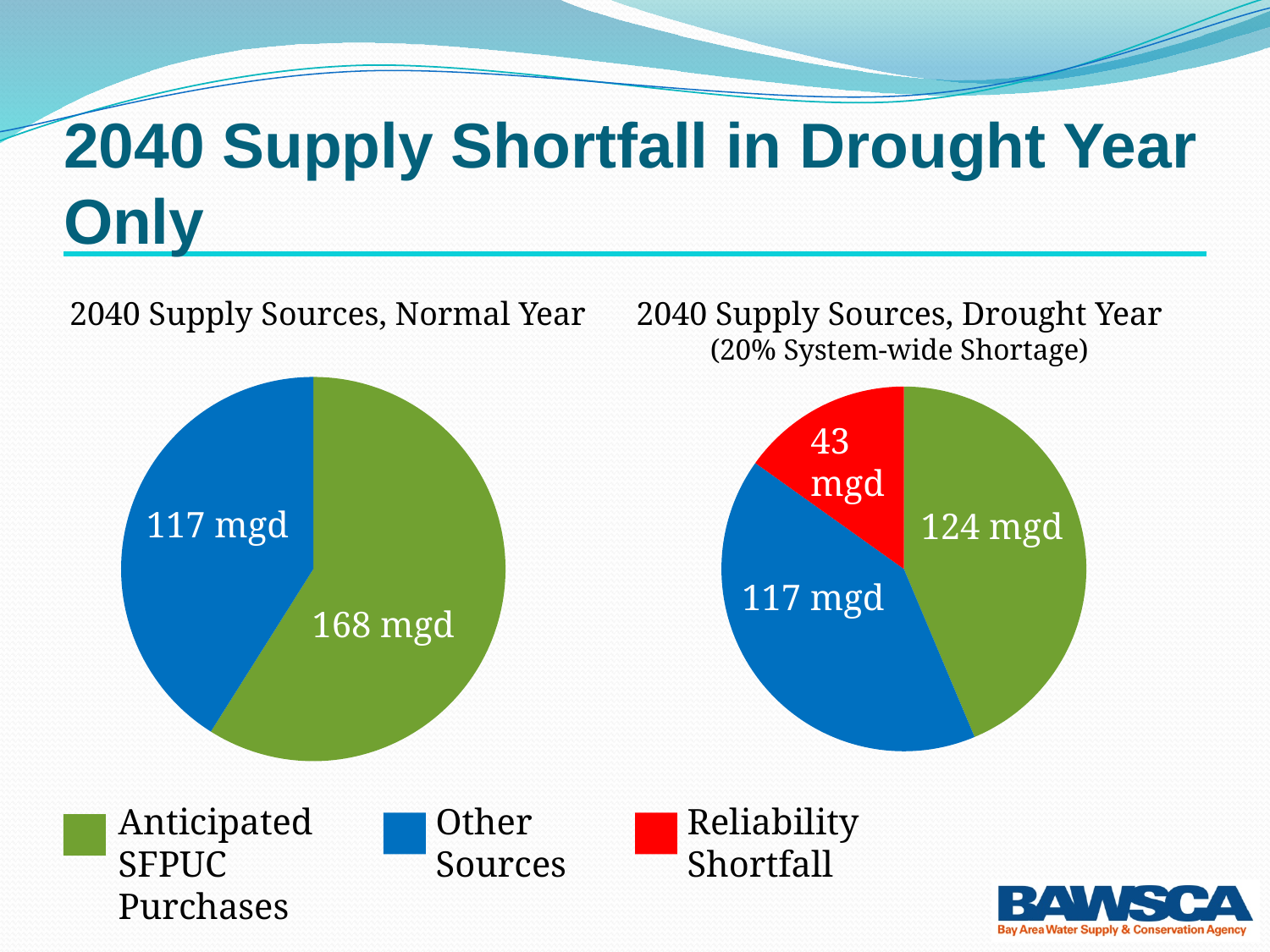
In the 2040 Supply Sources, Drought Year chart, which category has the smallest slice? Reliability Shortfall In the 2040 Supply Sources, Normal Year chart, what is the value for Other Sources? 117 mgd What kind of chart is used for 2040 Supply Sources, Normal Year? Pie chart Which colour represents Reliability Shortfall in the legend? Red How many slices does the 2040 Supply Sources, Drought Year chart have? 3 What is the difference between Anticipated SFPUC Purchases in the Normal Year chart and in the Drought Year chart? 44 mgd In the 2040 Supply Sources, Drought Year chart, what is the value for Reliability Shortfall? 43 mgd In the 2040 Supply Sources, Drought Year chart, which is larger, Anticipated SFPUC Purchases or Reliability Shortfall? Anticipated SFPUC Purchases In the 2040 Supply Sources, Normal Year chart, what is the value for Anticipated SFPUC Purchases? 168 mgd In the 2040 Supply Sources, Normal Year chart, what is the difference between Anticipated SFPUC Purchases and Other Sources? 51 mgd In the 2040 Supply Sources, Normal Year chart, which category has the largest slice? Anticipated SFPUC Purchases In the 2040 Supply Sources, Drought Year chart, what is the value for Anticipated SFPUC Purchases? 124 mgd